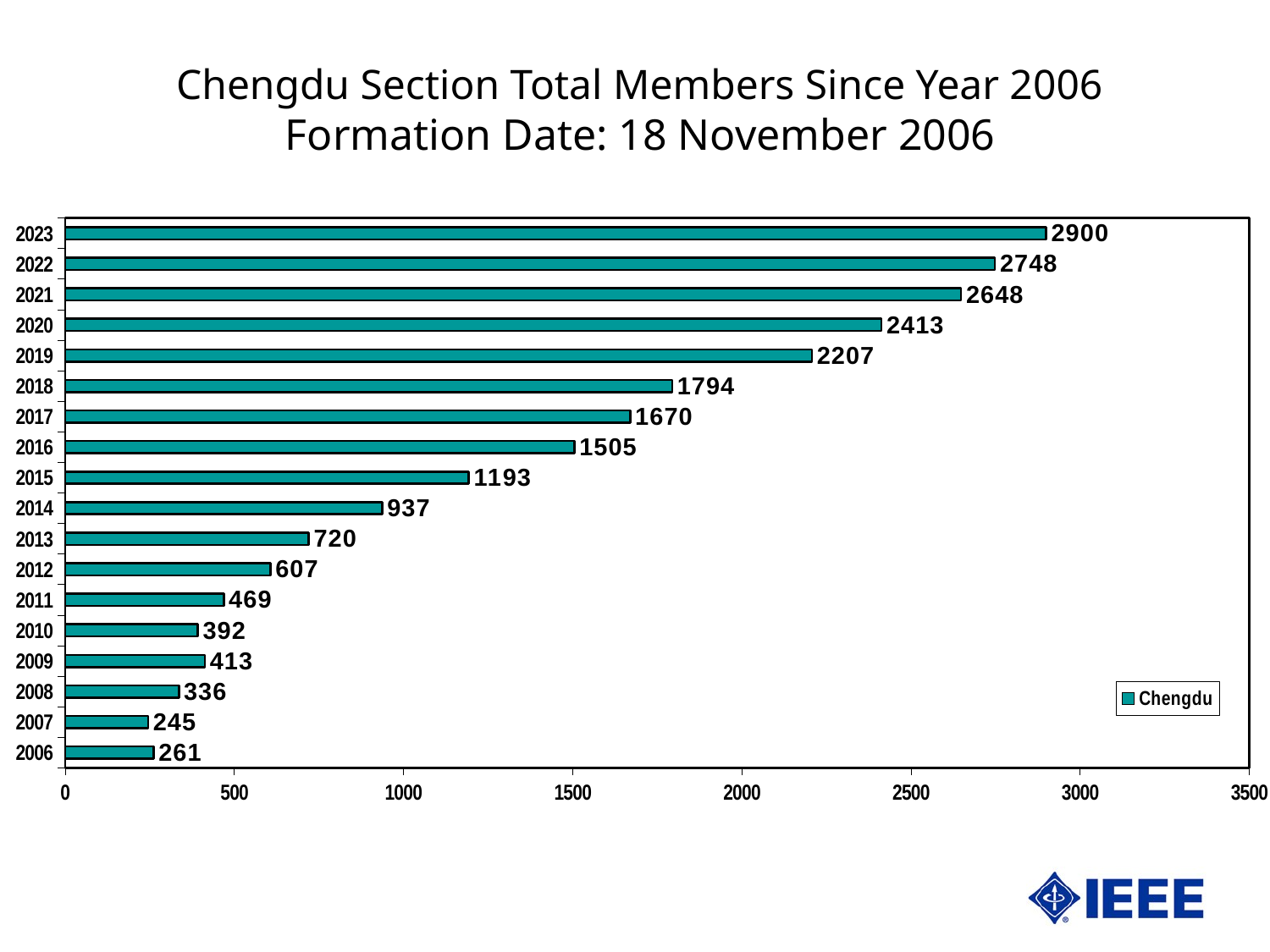
Which is larger, the value for 2006 or the value for 2007? 2006 What is the difference between the values for 2009 and 2010? 21 How many series does the legend list? 1 What is the value for 2009? 413 What is the difference between the values for 2023 and 2022? 152 What is the value for 2015? 1193 How many years are shown in the chart? 18 What is the value for 2023? 2900 Which year has the lowest value? 2007 Which year has the highest value? 2023 Is the value for 2019 greater or less than 2000? greater What kind of chart is shown? bar chart